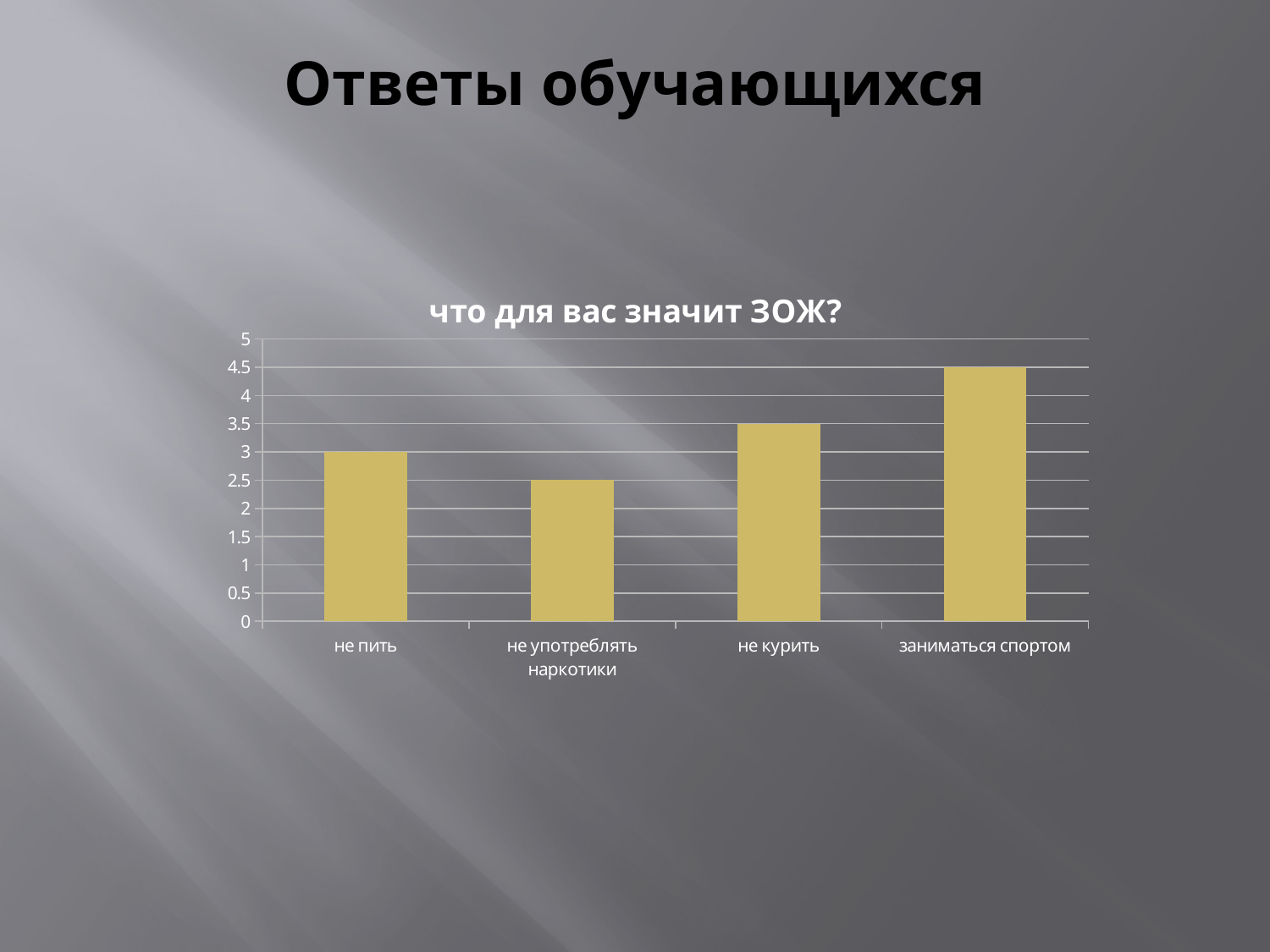
What is the value for 'заниматься спортом'? 4.5 What is the value for 'не курить'? 3.5 What kind of chart is shown on the slide? bar chart Is the value for 'заниматься спортом' greater or less than 4? greater Which is larger, the value for 'не курить' or the value for 'не пить'? не курить What is the title of the chart? что для вас значит ЗОЖ? What is the value for 'не пить'? 3 What is the difference between the values for 'заниматься спортом' and 'не пить'? 1.5 Which category has the highest value? заниматься спортом How many categories are shown on the x axis of the chart? 4 What is the value for 'не употреблять наркотики'? 2.5 Which category has the lowest value? не употреблять наркотики